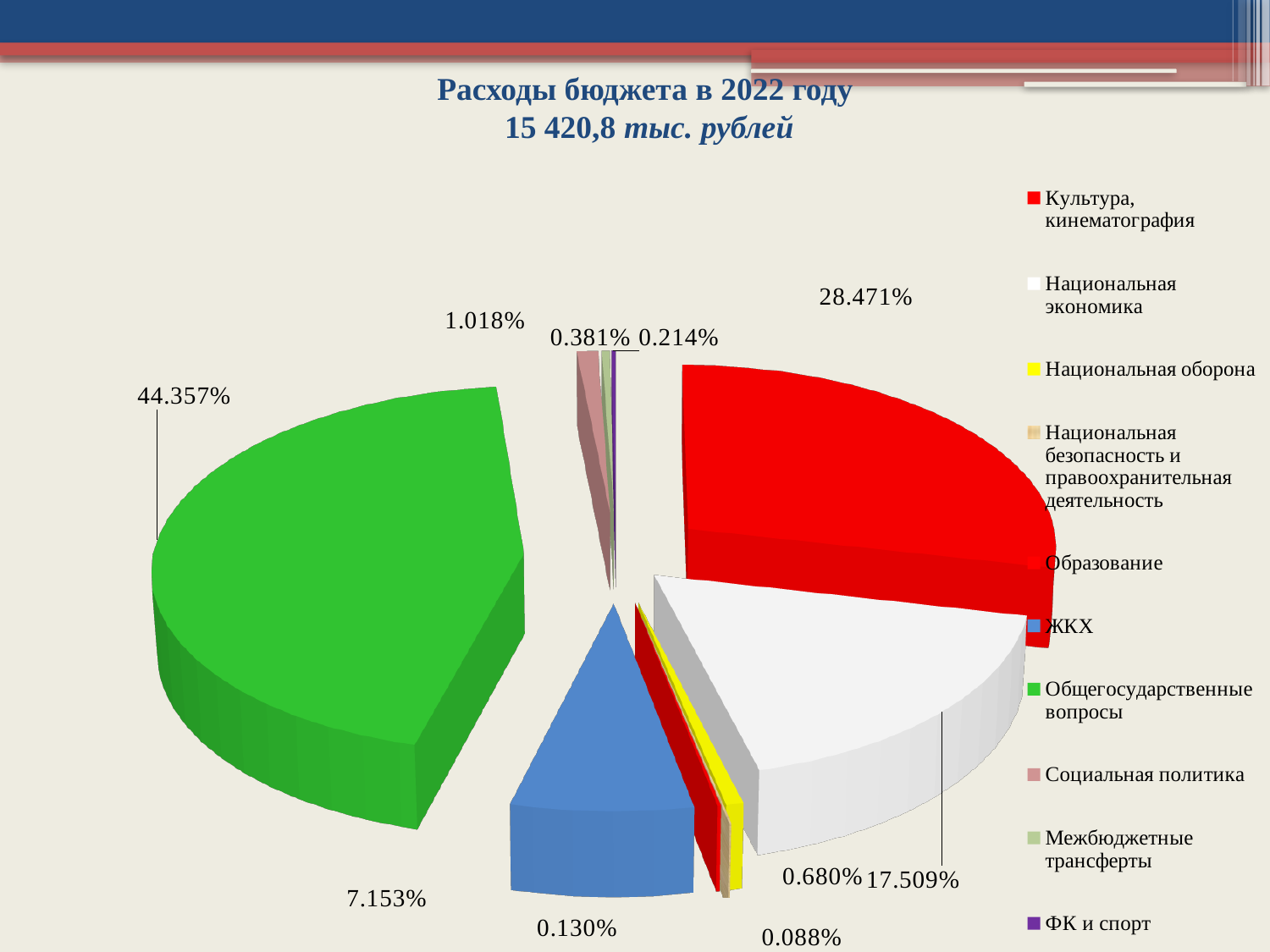
What is the title of the chart? Расходы бюджета в 2022 году 15 420,8 тыс. рублей What is the difference between the shares for Общегосударственные вопросы and Культура, кинематография? 15.886% What share of the pie is Культура, кинематография? 28.471% What kind of chart is shown on the slide? pie chart Which category has the largest share of the pie? Общегосударственные вопросы Which is larger, the share for Культура, кинематография or the share for Национальная экономика? Культура, кинематография Which category has the smallest share of the pie? Национальная безопасность и правоохранительная деятельность How many categories does the legend list? 10 What share of the pie is Национальная экономика? 17.509% What share of the pie is ЖКХ? 7.153%